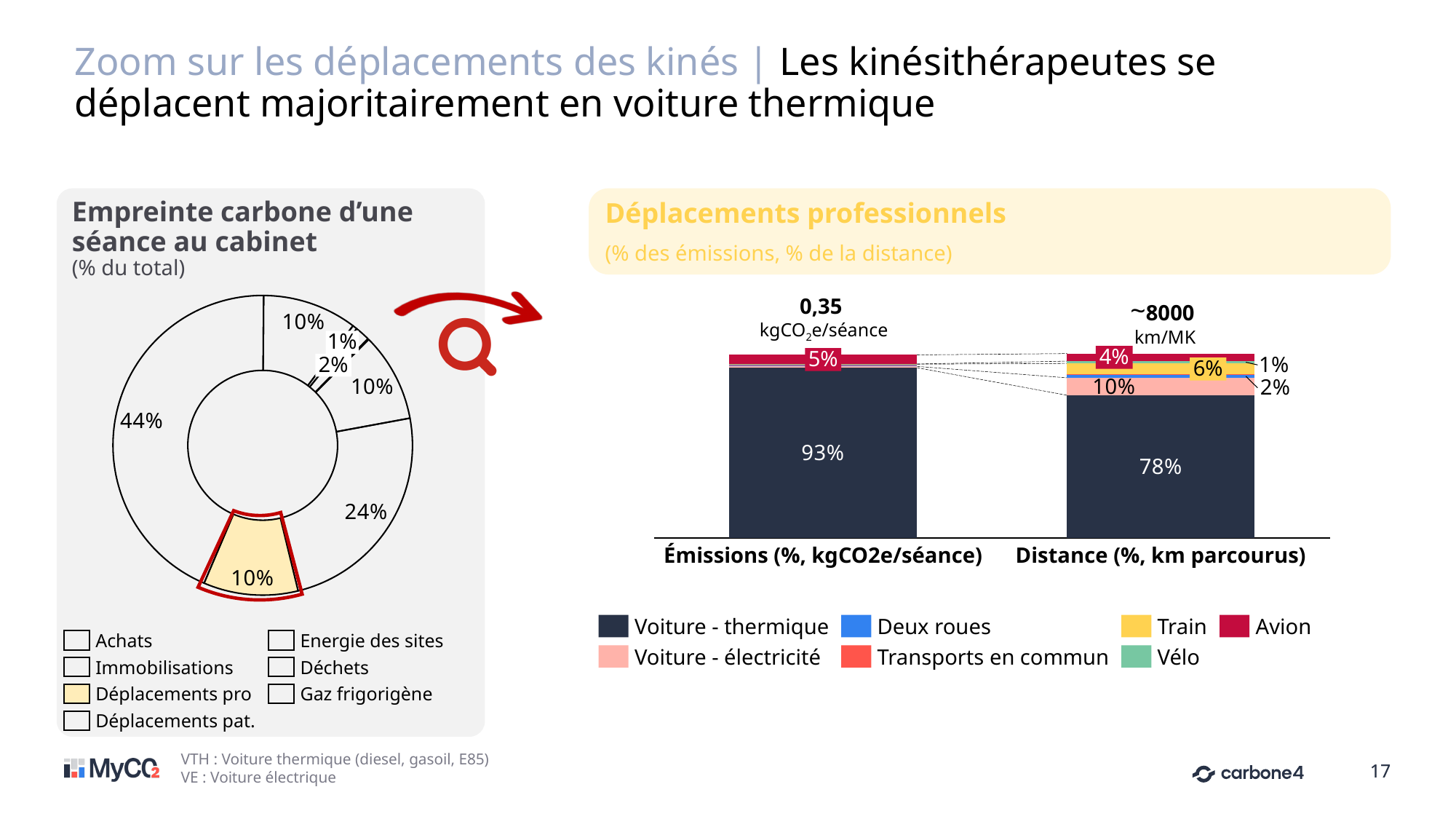
In the 'Déplacements professionnels' chart, what total value is printed above the Émissions bar? 0,35 kgCO2e/séance In the 'Déplacements professionnels' chart, what share of distance is travelled by Voiture - thermique? 78% In the 'Empreinte carbone d'une séance au cabinet' chart, what is the value of the largest slice? 44% In the 'Empreinte carbone d'une séance au cabinet' chart, what share of the total is Déplacements pro? 10% In the 'Déplacements professionnels' chart, is the Avion share larger for emissions or for distance? Emissions In the 'Déplacements professionnels' chart, what share of distance is travelled by Train? 6% In the 'Déplacements professionnels' chart, what is the difference in percentage points between the Voiture - thermique share of emissions and its share of distance? 15 percentage points In the 'Déplacements professionnels' chart, what share of emissions comes from Voiture - thermique? 93% In the 'Déplacements professionnels' chart, what share of emissions comes from Avion? 5% What kind of chart is the 'Déplacements professionnels' chart? Stacked bar chart In the 'Déplacements professionnels' chart, what share of distance is travelled by Voiture - électricité? 10% How many series does the legend of the 'Déplacements professionnels' chart list? 7